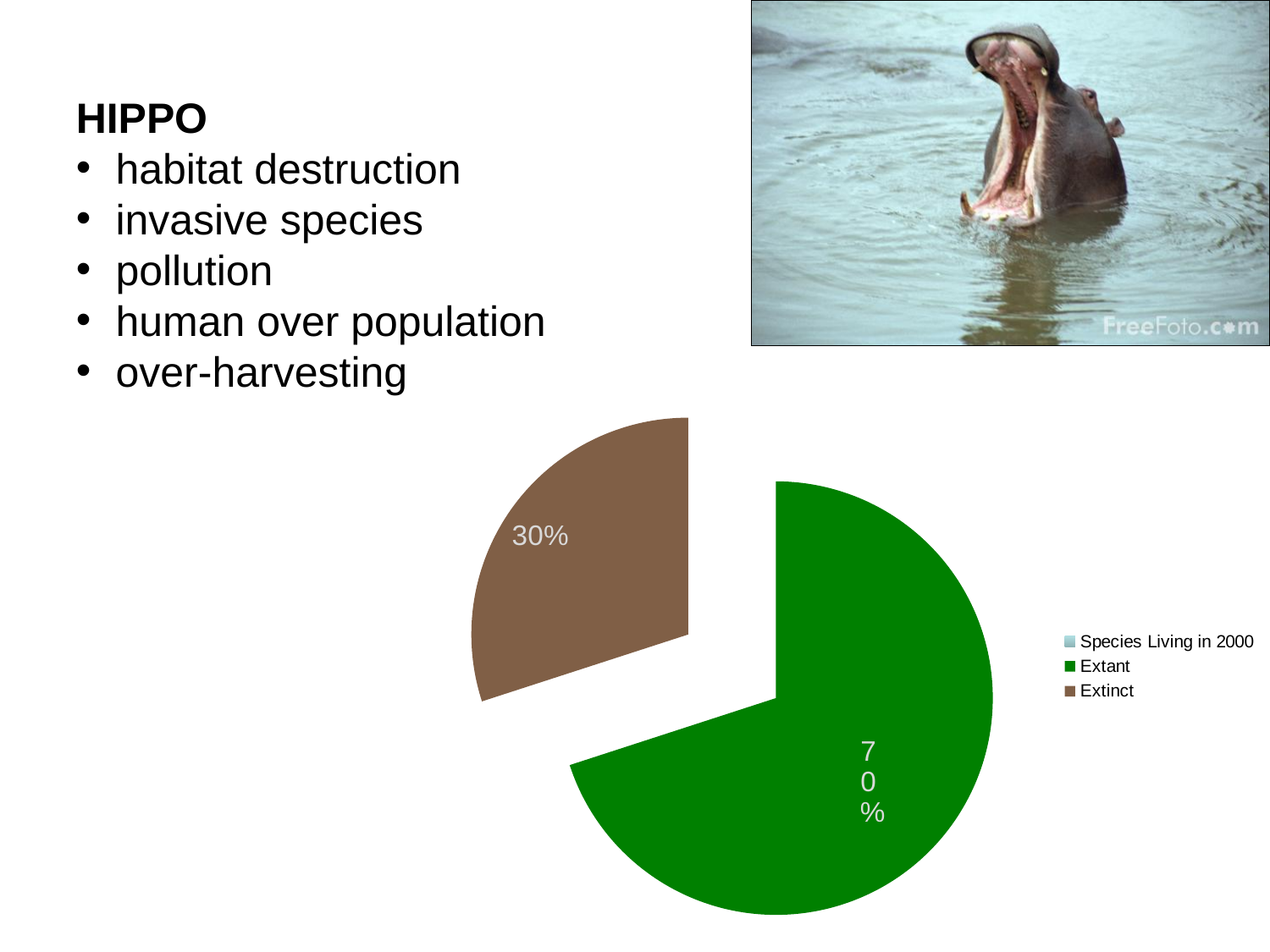
What is the difference in percentage points between the Extant and Extinct slices? 40 Which is larger, the Extant slice or the Extinct slice? Extant What share of the pie is labelled Extinct? 30% Which slice of the pie is the largest? Extant How many slices with data labels are visible in the pie chart? 2 What colour is the Extant slice of the pie chart? green What colour is the Extinct slice of the pie chart? brown How many entries does the legend of the pie chart list? 3 Which slice of the pie is the smallest? Extinct What kind of chart is shown on the slide? pie chart What share of the pie is labelled Extant? 70%